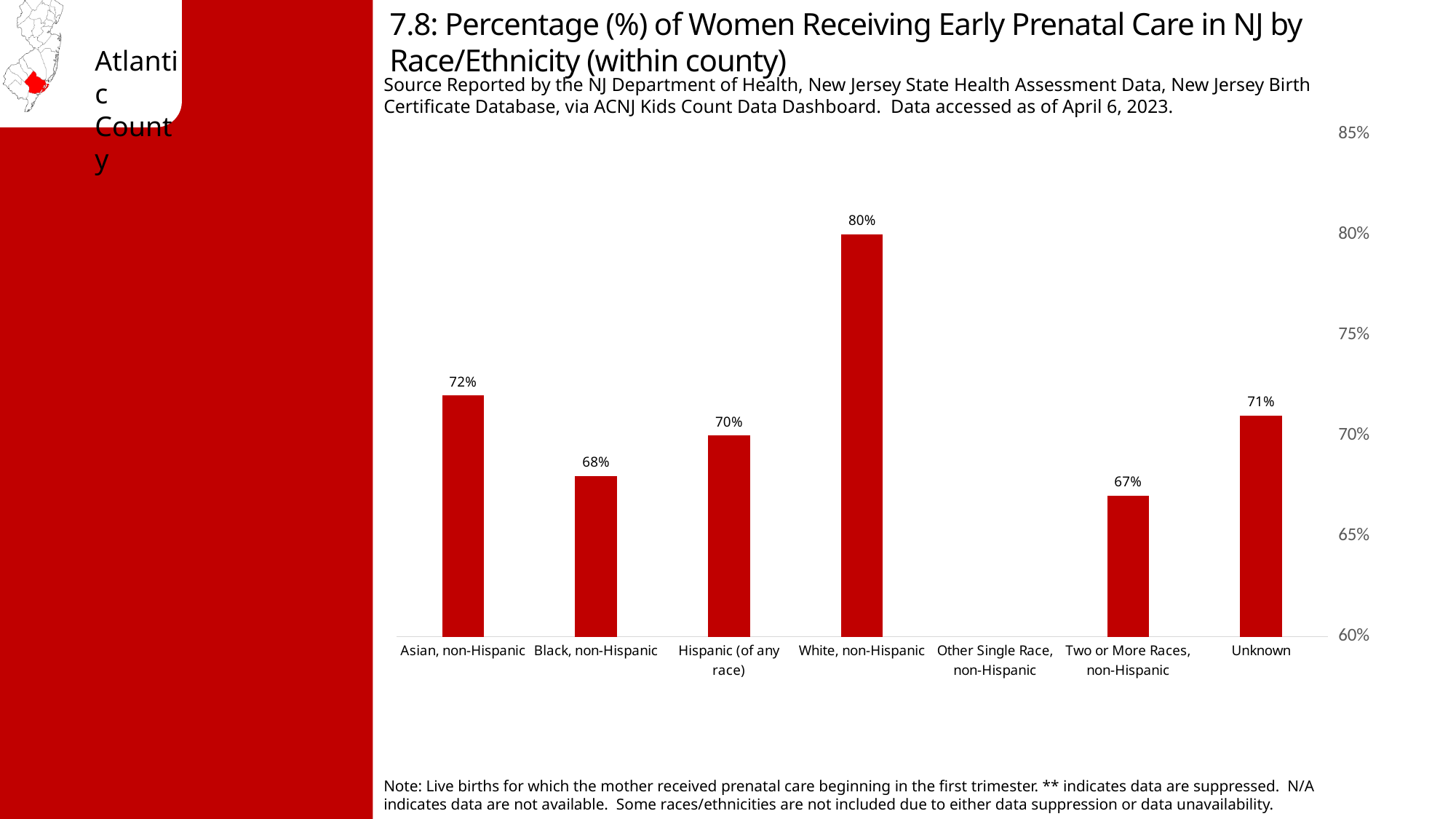
What is the value shown for Unknown? 71% What is the value shown for Two or More Races, non-Hispanic? 67% Which category on the x axis has no bar displayed? Other Single Race, non-Hispanic What is the difference between the White, non-Hispanic value and the Black, non-Hispanic value? 12% What kind of chart is shown on the slide? Bar chart Which is larger, the value for Hispanic (of any race) or the value for Black, non-Hispanic? Hispanic (of any race) How many race/ethnicity categories are labeled on the x axis? 7 Among the categories with a bar shown, which has the lowest percentage? Two or More Races, non-Hispanic Is the value for Asian, non-Hispanic greater or less than 70%? greater What is the value shown for Asian, non-Hispanic? 72% What percentage of White, non-Hispanic women received early prenatal care? 80% Which race/ethnicity category has the highest percentage of women receiving early prenatal care? White, non-Hispanic